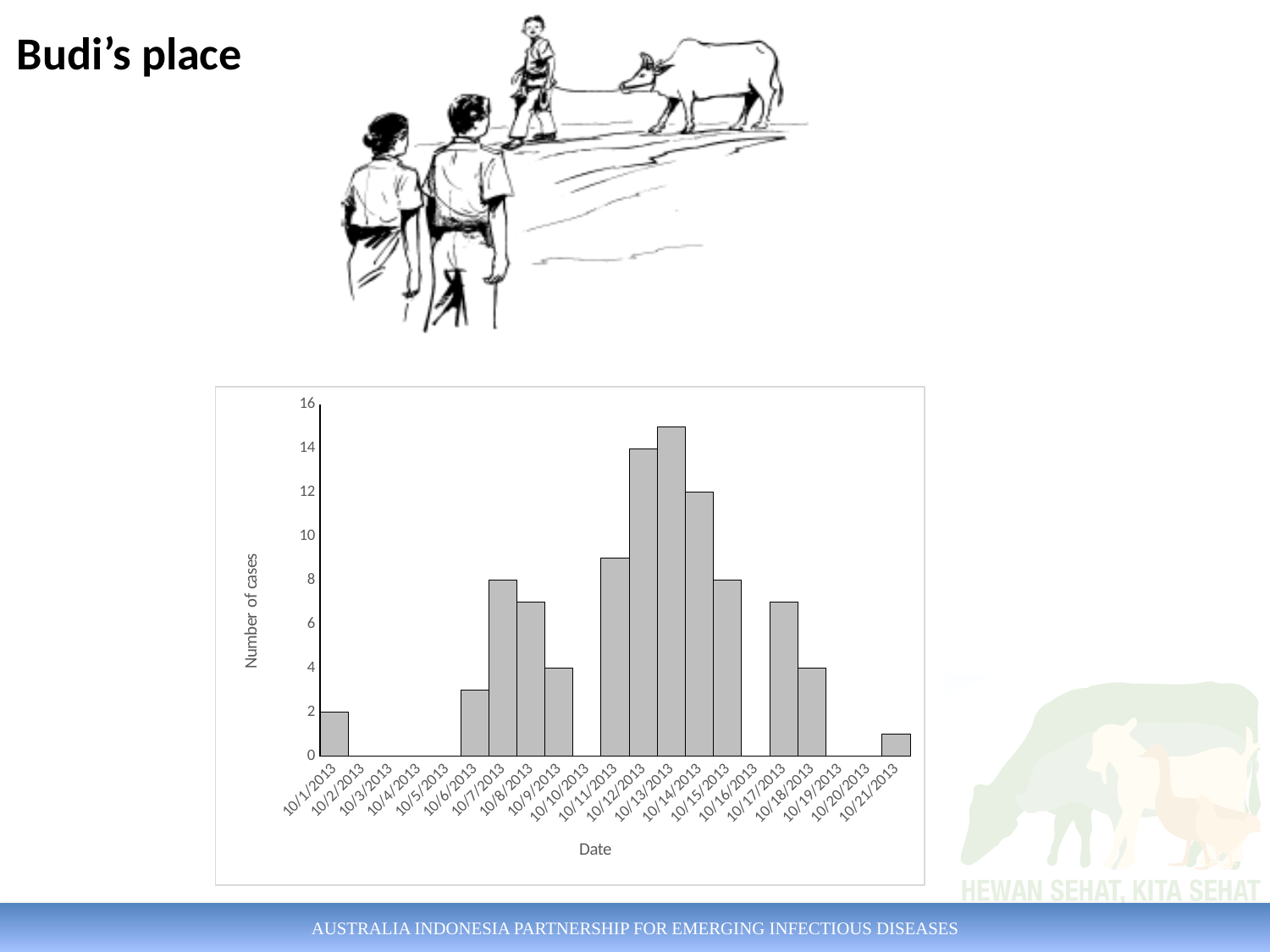
Which date has the highest number of cases? 10/13/2013 What is the number of cases on 10/14/2013? 12 What is the number of cases on 10/1/2013? 2 What is the label of the y axis of the chart? Number of cases What is the number of cases on 10/18/2013? 4 What kind of chart is shown on the slide? bar chart How many dates are labelled on the x axis of the chart? 21 Which date has more cases, 10/14/2013 or 10/18/2013? 10/14/2013 What is the number of cases on 10/12/2013? 14 Is the number of cases on 10/21/2013 greater or less than 2? less What is the difference in number of cases between 10/12/2013 and 10/14/2013? 2 Is the number of cases on 10/13/2013 greater or less than 14? greater